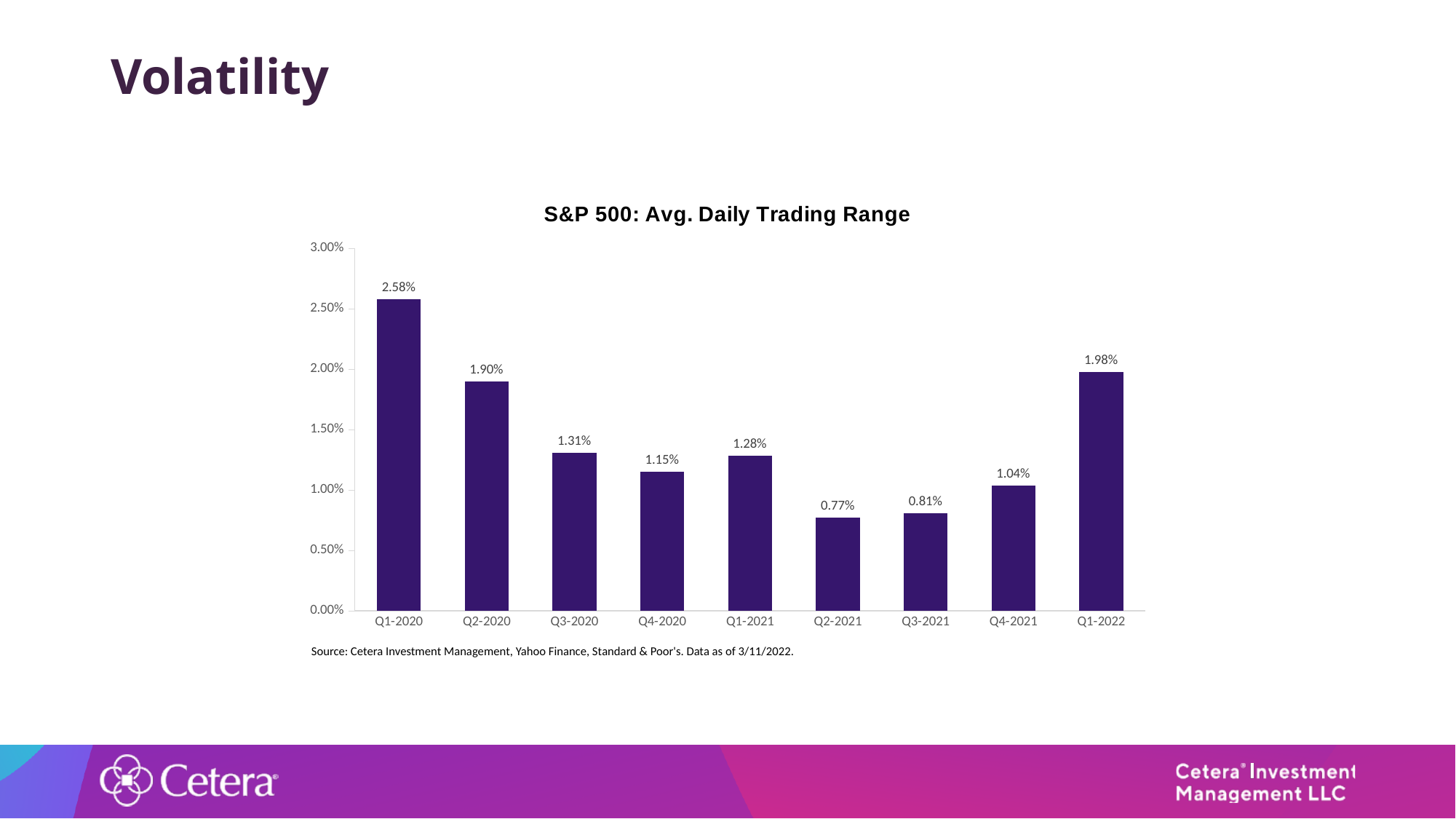
Which quarter has the highest average daily trading range? Q1-2020 What is the average daily trading range for Q1-2022? 1.98% What is the value shown for Q4-2021? 1.04% Is the value for Q1-2022 greater or less than 1.50%? greater What is the difference between the values for Q1-2020 and Q2-2020? 0.68% What is the title of the chart? S&P 500: Avg. Daily Trading Range Which quarter has the lowest average daily trading range? Q2-2021 How many quarters are shown on the x axis? 9 What kind of chart is shown on the slide? Bar chart Do the values rise or fall from Q1-2020 to Q2-2021? Fall What is the average daily trading range for Q1-2020? 2.58% Which is larger, the value for Q3-2020 or the value for Q1-2021? Q3-2020